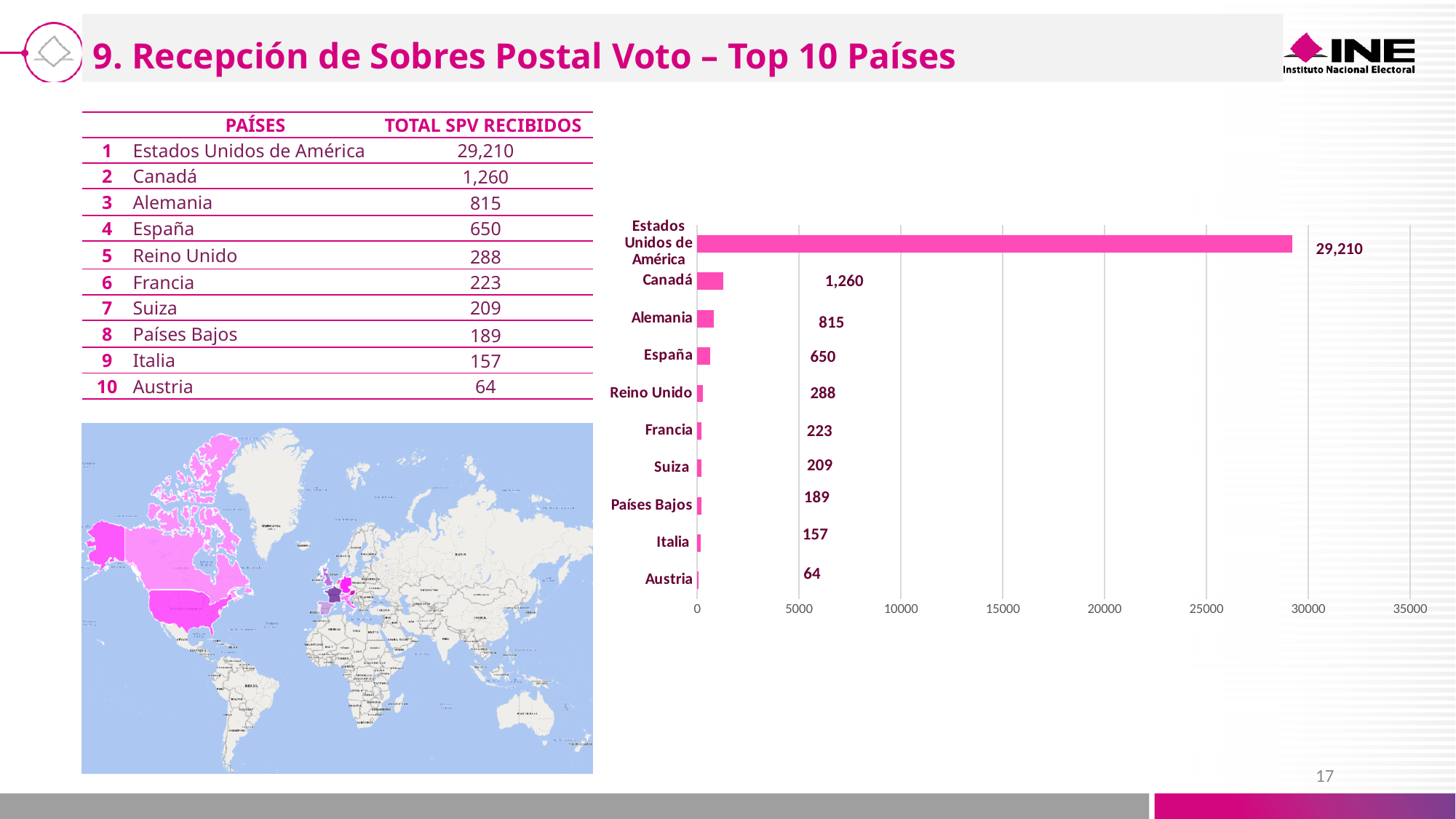
What is the difference between the values for Alemania and España in the bar chart? 165 What is the value for Canadá in the bar chart? 1,260 Which country has the highest value in the bar chart? Estados Unidos de América Which has a larger value in the bar chart, Francia or Italia? Francia What is the value for Estados Unidos de América in the bar chart? 29,210 What kind of chart is shown on the right of the slide? bar chart What is the value for Suiza in the bar chart? 209 How many countries are shown in the bar chart? 10 Which country has the lowest value in the bar chart? Austria What is the difference between the values for Canadá and Austria in the bar chart? 1,196 Is the value for Estados Unidos de América in the bar chart greater or less than 25000? greater What is the highest value shown on the horizontal axis of the bar chart? 35000